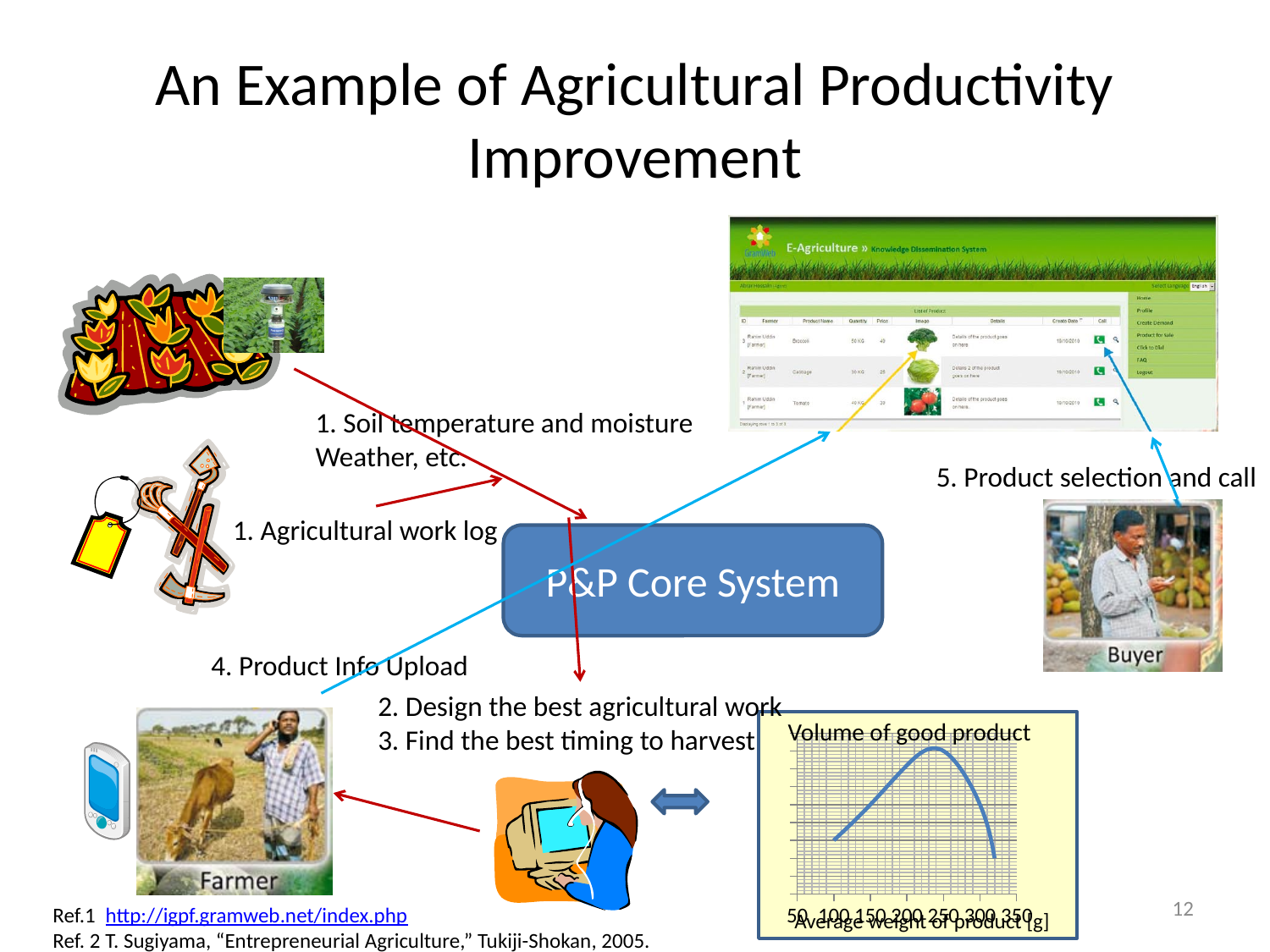
In the 'Volume of good product' chart, how does the curve behave overall as average weight increases from 50 to 350? rises then falls In the 'Volume of good product' chart, does the curve rise or fall between 100 and 200 on the x axis? rise What kind of chart is shown in the 'Volume of good product' box at the bottom right of the slide? line chart In the 'Volume of good product' chart, does the curve rise or fall between 300 and 350 on the x axis? fall In the 'Volume of good product' chart, which has the larger volume of good product: an average weight of 100 or 250? 250 What is the title of the chart at the bottom right of the slide? Volume of good product How many tick labels are shown on the x axis of the 'Volume of good product' chart? 7 What is the lowest tick label on the x axis of the 'Volume of good product' chart? 50 What is the x-axis label of the 'Volume of good product' chart? Average weight of product [g]